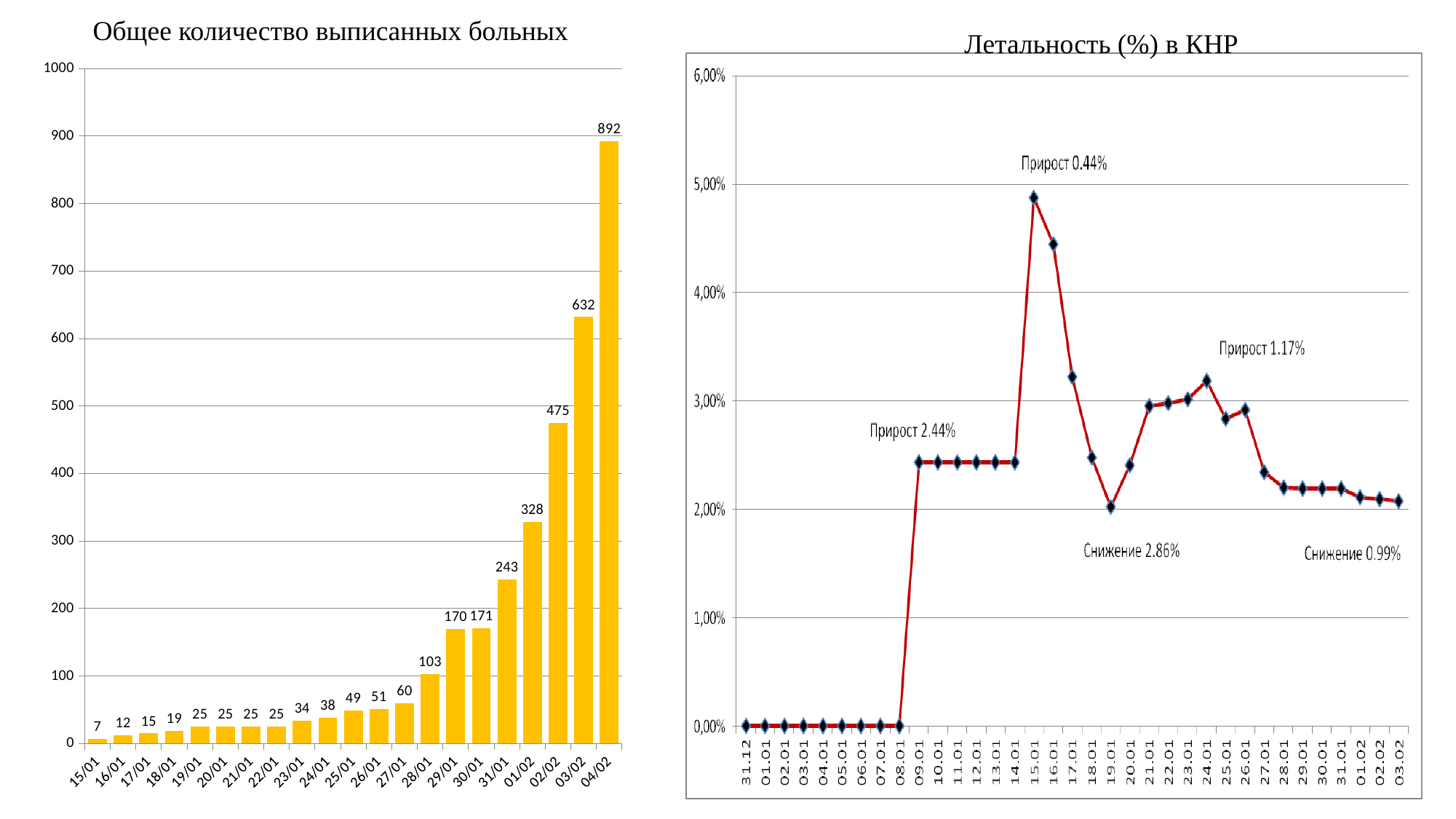
On the chart titled 'Общее количество выписанных больных', which date has the lowest value? 15/01 What kind of chart is the one titled 'Летальность (%) в КНР'? line chart On the chart titled 'Общее количество выписанных больных', how many bars are plotted? 21 On the chart titled 'Общее количество выписанных больных', what is the value for 28/01? 103 On the chart titled 'Общее количество выписанных больных', what is the difference between the values for 04/02 and 03/02? 260 On the chart titled 'Летальность (%) в КНР', is the value for 15.01 greater or less than 4,00%? greater On the chart titled 'Общее количество выписанных больных', what is the value for 04/02? 892 On the chart titled 'Общее количество выписанных больных', which date has the highest value? 04/02 On the chart titled 'Общее количество выписанных больных', which is larger, the value for 31/01 or the value for 01/02? 01/02 On the chart titled 'Летальность (%) в КНР', which date has the highest value? 15.01 On the chart titled 'Летальность (%) в КНР', how many dates are shown on the x axis? 35 What kind of chart is the one titled 'Общее количество выписанных больных'? bar chart